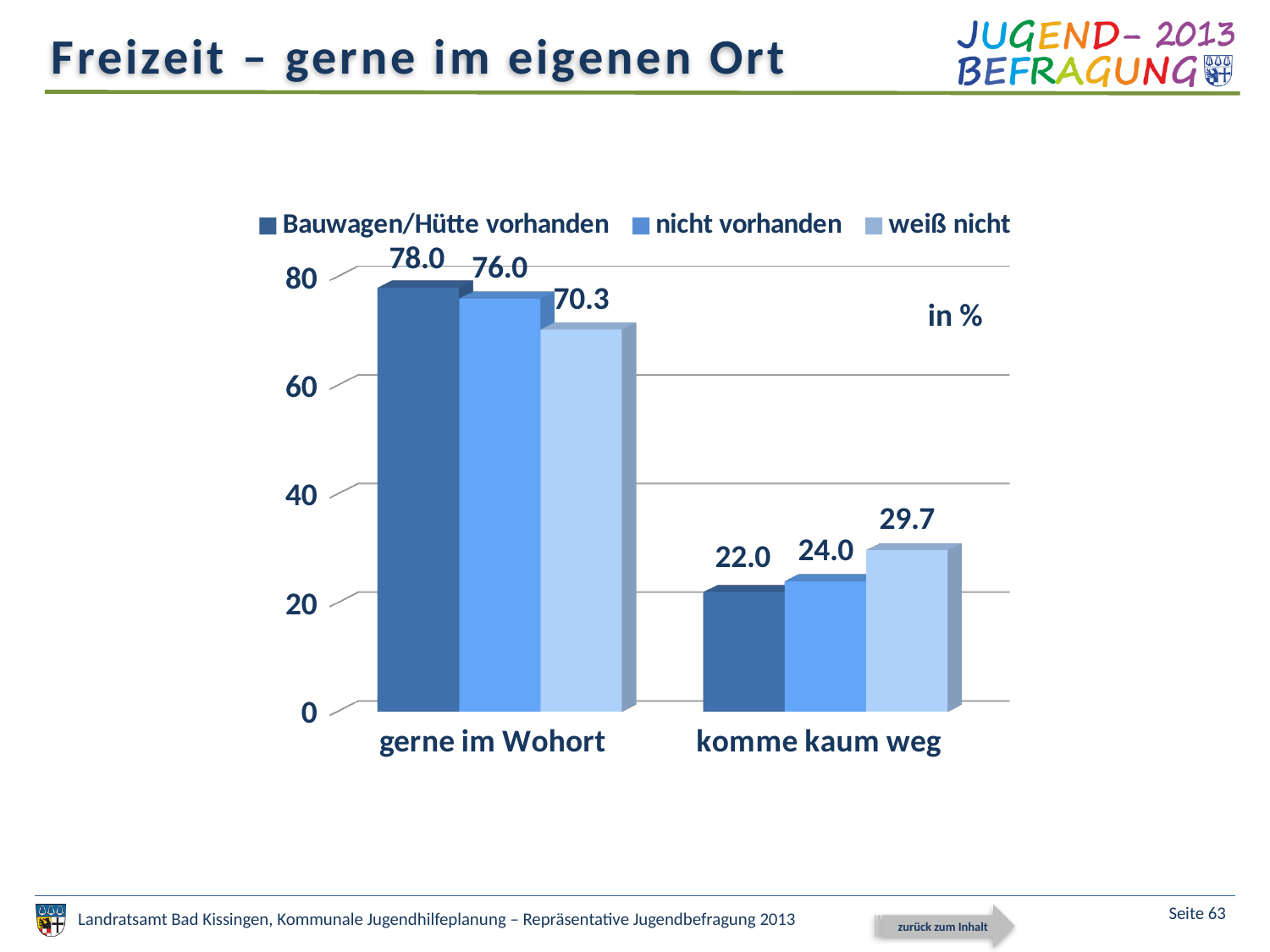
What is the value for "weiß nicht" in the "komme kaum weg" category? 29.7 What kind of chart is shown on the slide? bar chart How many series does the legend list? 3 How many categories are shown on the x axis? 2 What is the difference between the "Bauwagen/Hütte vorhanden" and "weiß nicht" values in the "gerne im Wohort" category? 7.7 What unit is indicated for the values in the chart? % What is the value for "Bauwagen/Hütte vorhanden" in the "gerne im Wohort" category? 78.0 Which series has the lowest value in the "gerne im Wohort" category? weiß nicht Which series has the highest value in the "komme kaum weg" category? weiß nicht What is the value for "nicht vorhanden" in the "gerne im Wohort" category? 76.0 Which is larger: the "nicht vorhanden" value for "gerne im Wohort" or for "komme kaum weg"? gerne im Wohort What is the difference between the "weiß nicht" and "Bauwagen/Hütte vorhanden" values in the "komme kaum weg" category? 7.7